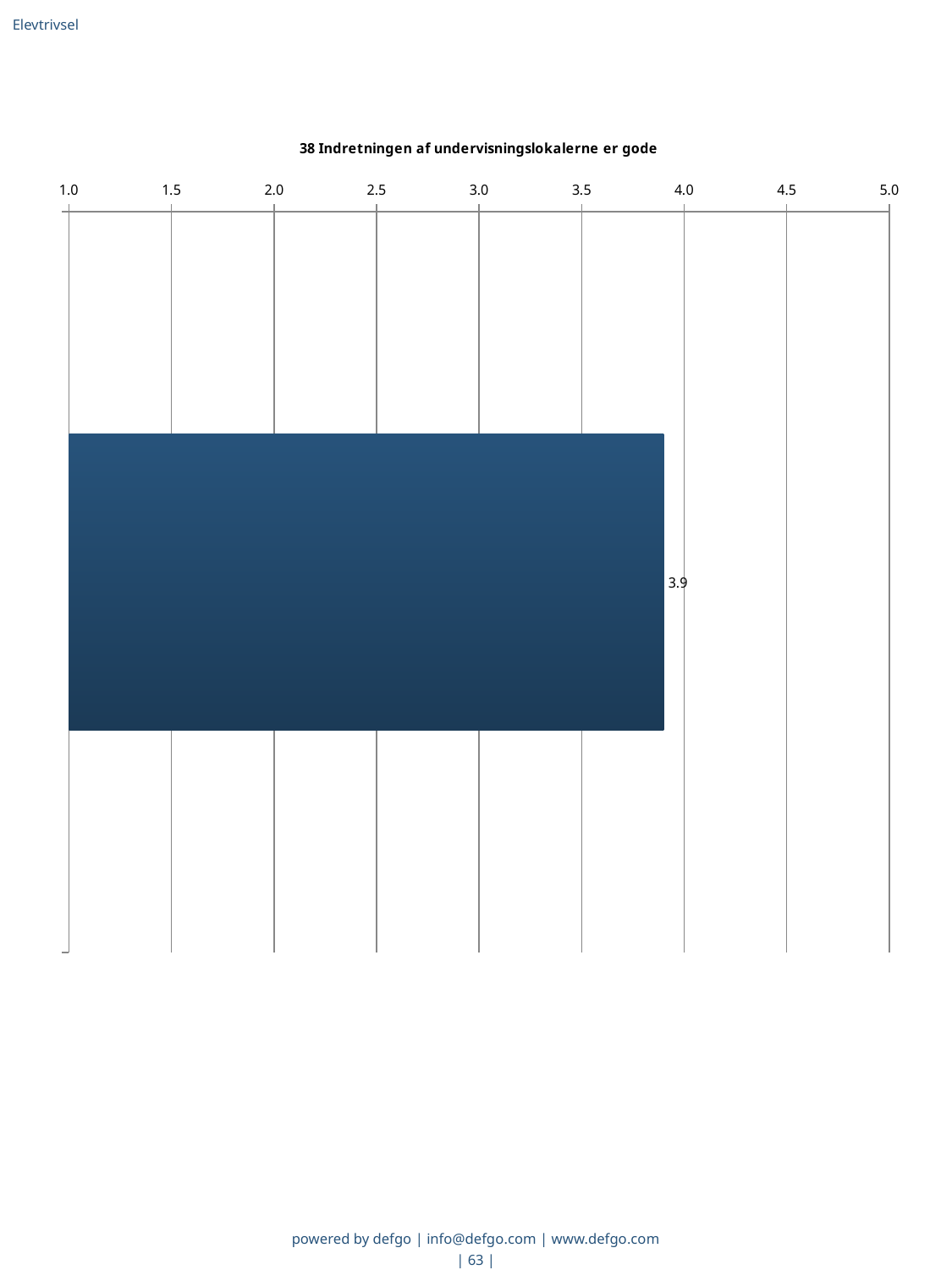
Is the value of the bar greater or less than 3.5? greater Are the bars in the chart horizontal or vertical? horizontal What kind of chart is shown on the slide? bar chart What is the highest value shown on the chart's axis? 5.0 Is the value of the bar greater or less than 4.0? less What is the lowest value shown on the chart's axis? 1.0 How many bars are plotted in the chart? 1 What is the title of the chart? 38 Indretningen af undervisningslokalerne er gode What is the value shown by the data label on the bar? 3.9